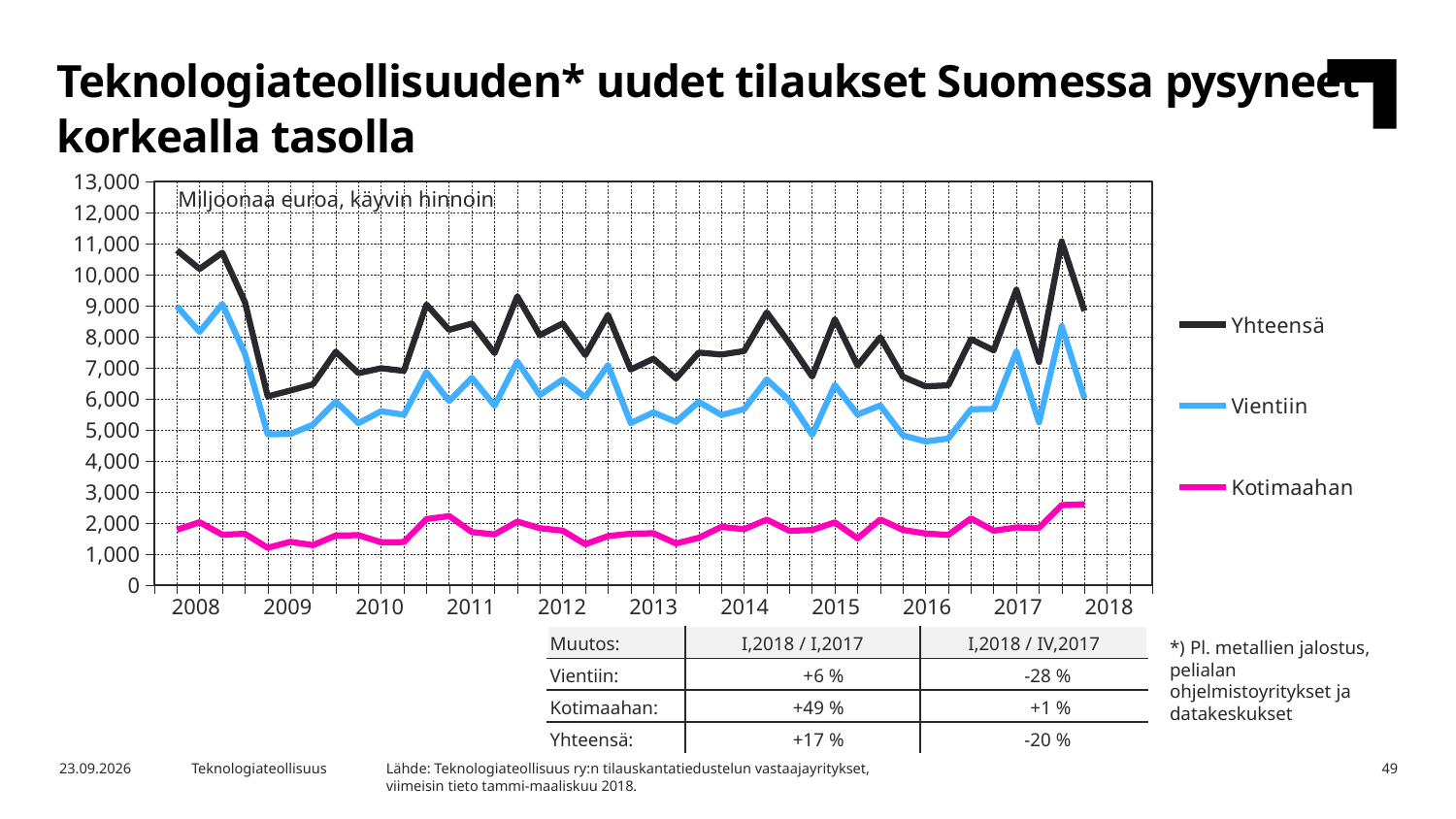
Is the lowest value for Vientiin in 2016 greater or less than 5,000? less What kind of chart is shown on the slide? Line chart Does the Yhteensä line rise or fall from the start of 2008 to the start of 2009? fall How many year labels are shown on the x axis? 11 Which series has the lowest values throughout the whole period? Kotimaahan Which series are listed in the chart legend? Yhteensä, Vientiin, Kotimaahan Is the value for Yhteensä at the start of 2008 greater or less than 10,000? greater What unit label is printed inside the chart area? Miljoonaa euroa, käyvin hinnoin Is the highest value for Yhteensä in 2017 greater or less than 10,000? greater How many series does the chart legend list? 3 Which series has the highest values throughout the whole period? Yhteensä